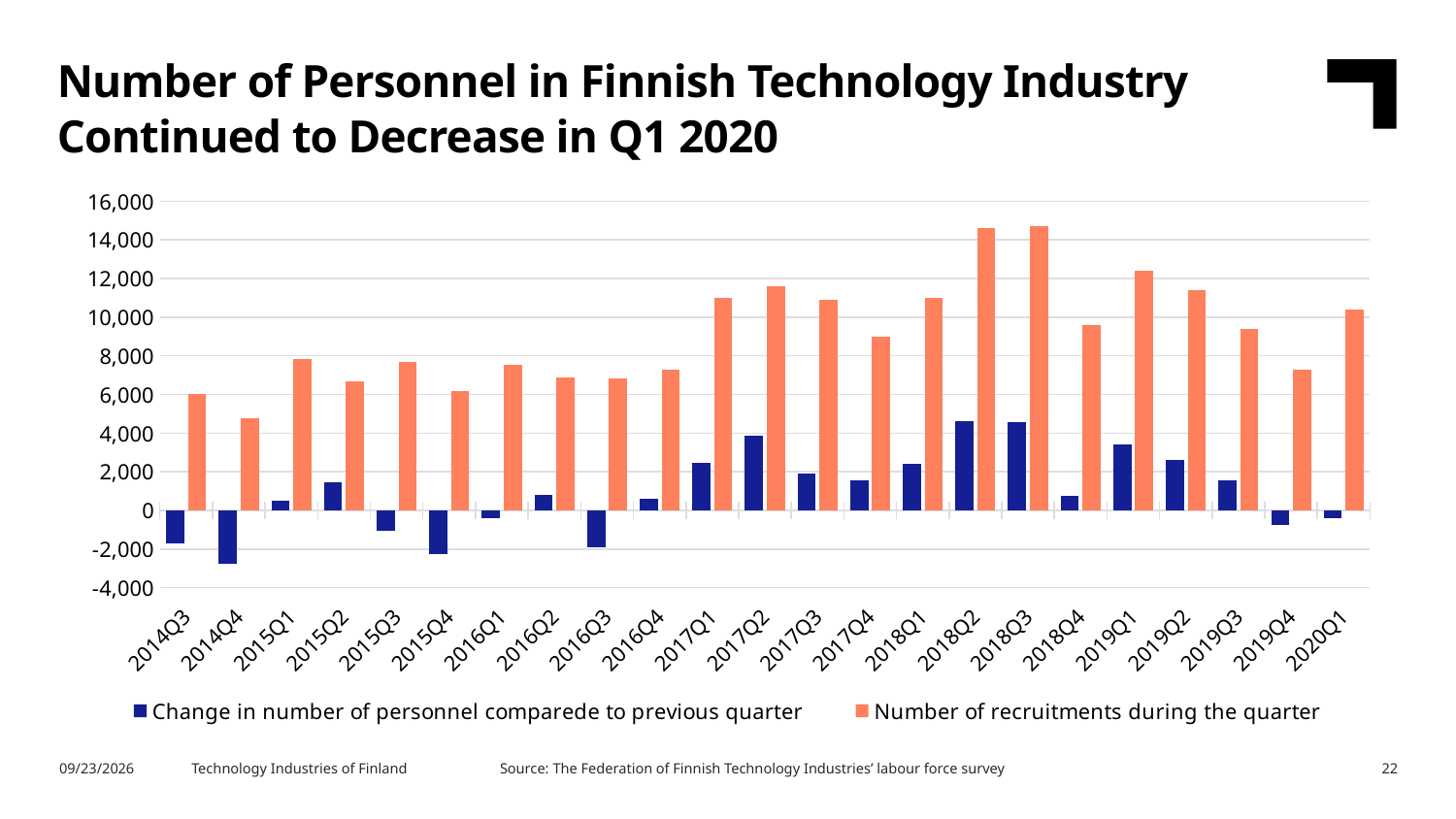
Which colour represents the number of recruitments during the quarter in the legend? orange Is the number of recruitments during the quarter for 2018Q2 greater or less than 14,000? greater How many quarters are shown on the x axis? 23 What kind of chart is shown on the slide? bar chart Do the number of recruitments during the quarter rise or fall from 2018Q3 to 2019Q4? fall Which quarter has the lowest number of recruitments during the quarter? 2014Q4 Is the change in number of personnel compared to previous quarter for 2020Q1 greater or less than 0? less Is the number of recruitments during the quarter for 2020Q1 greater or less than 10,000? greater Which quarter has the lowest (most negative) change in number of personnel compared to previous quarter? 2014Q4 How many series does the legend list? 2 Which quarter has the larger number of recruitments during the quarter, 2019Q2 or 2019Q3? 2019Q2